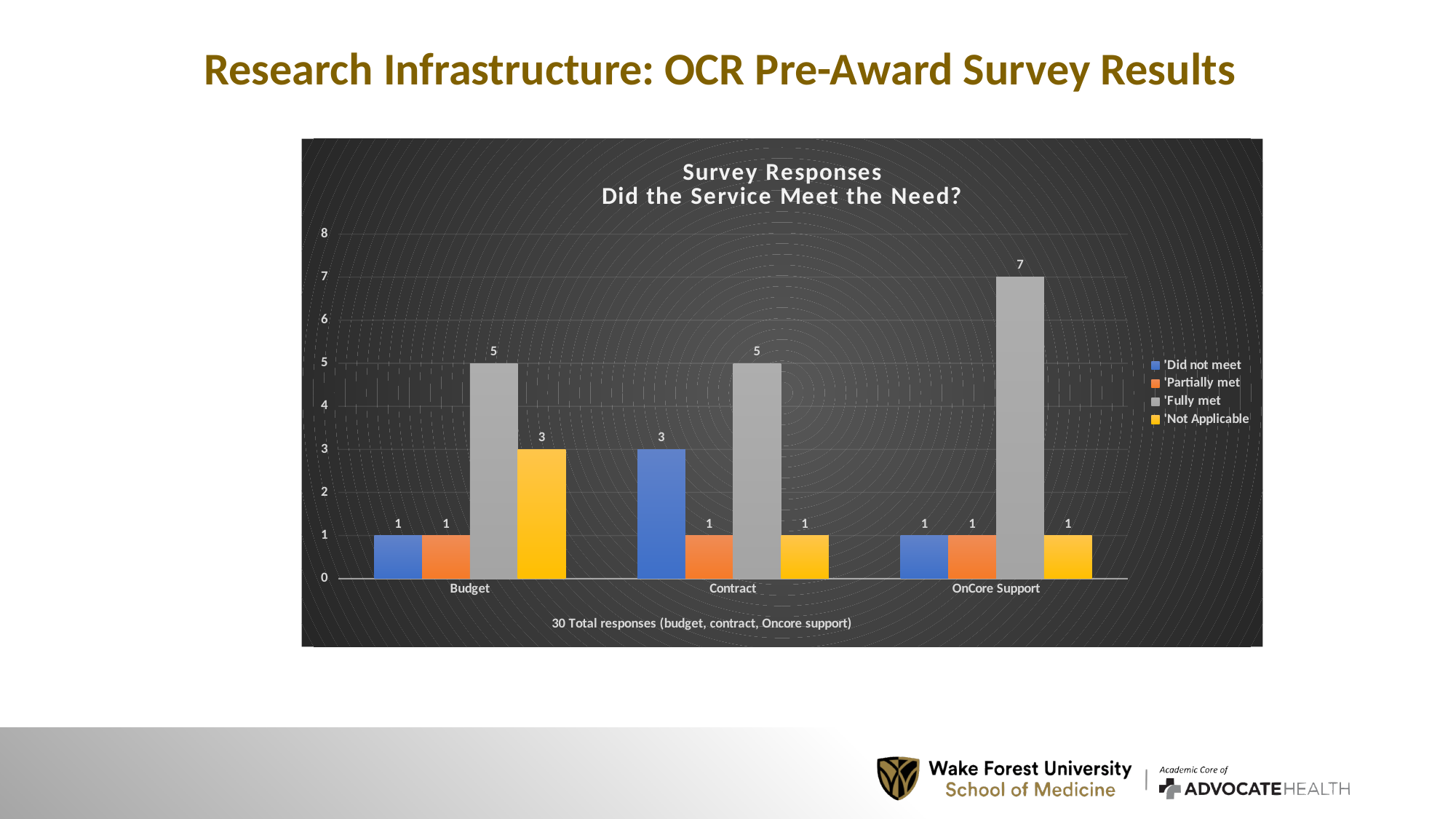
Which is larger: 'Did not meet' for Contract or 'Did not meet' for Budget? Contract How many categories are shown on the x axis? 3 What is the value for 'Not Applicable' in the Budget category? 3 What is the value for 'Fully met' in the OnCore Support category? 7 What is the title of the chart? Survey Responses Did the Service Meet the Need? What is the value for 'Did not meet' in the Contract category? 3 What is the value for 'Partially met' in the Contract category? 1 Which category has the lowest 'Not Applicable' value? Contract and OnCore Support (both 1) What is the difference between the 'Fully met' values for OnCore Support and Budget? 2 Which category has the highest 'Fully met' value? OnCore Support What kind of chart is shown on the slide? Bar chart How many series does the legend list? 4